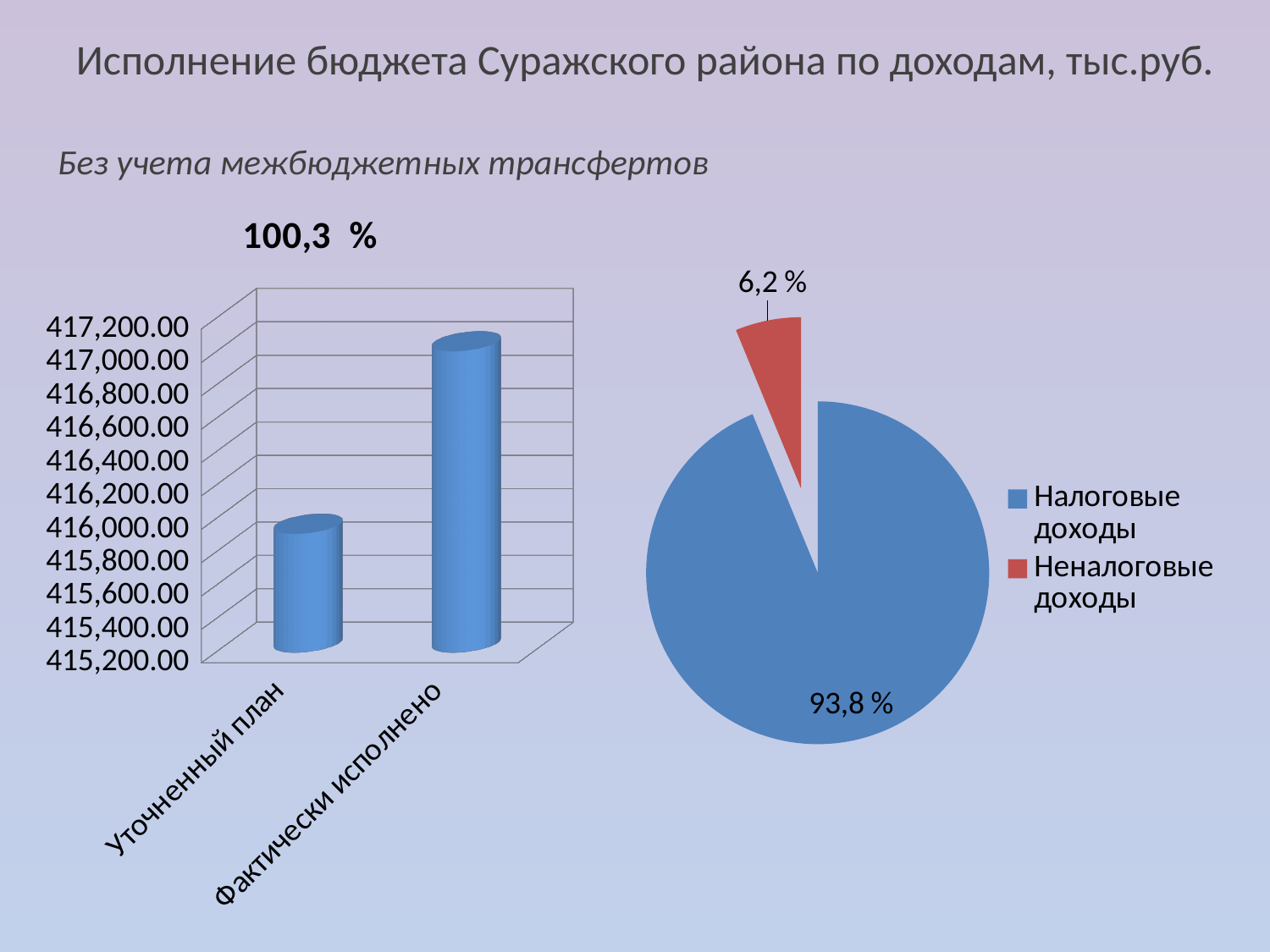
In the bar chart on the left, is the value for Фактически исполнено greater or less than 416,600.00? greater In the bar chart on the left, how many categories are shown? 2 In the pie chart on the right, which slice is the largest? Налоговые доходы What kind of chart is the chart on the right side of the slide? pie chart In the bar chart on the left, which is larger: Уточненный план or Фактически исполнено? Фактически исполнено What kind of chart is the chart on the left side of the slide? bar chart In the bar chart on the left, which category has the highest value? Фактически исполнено In the bar chart on the left, which category has the lowest value? Уточненный план How many entries does the legend of the pie chart on the right list? 2 In the pie chart on the right, what share does Неналоговые доходы have? 6,2 % In the pie chart on the right, what share does Налоговые доходы have? 93,8 % In the bar chart on the left, is the value for Уточненный план greater or less than 416,400.00? less